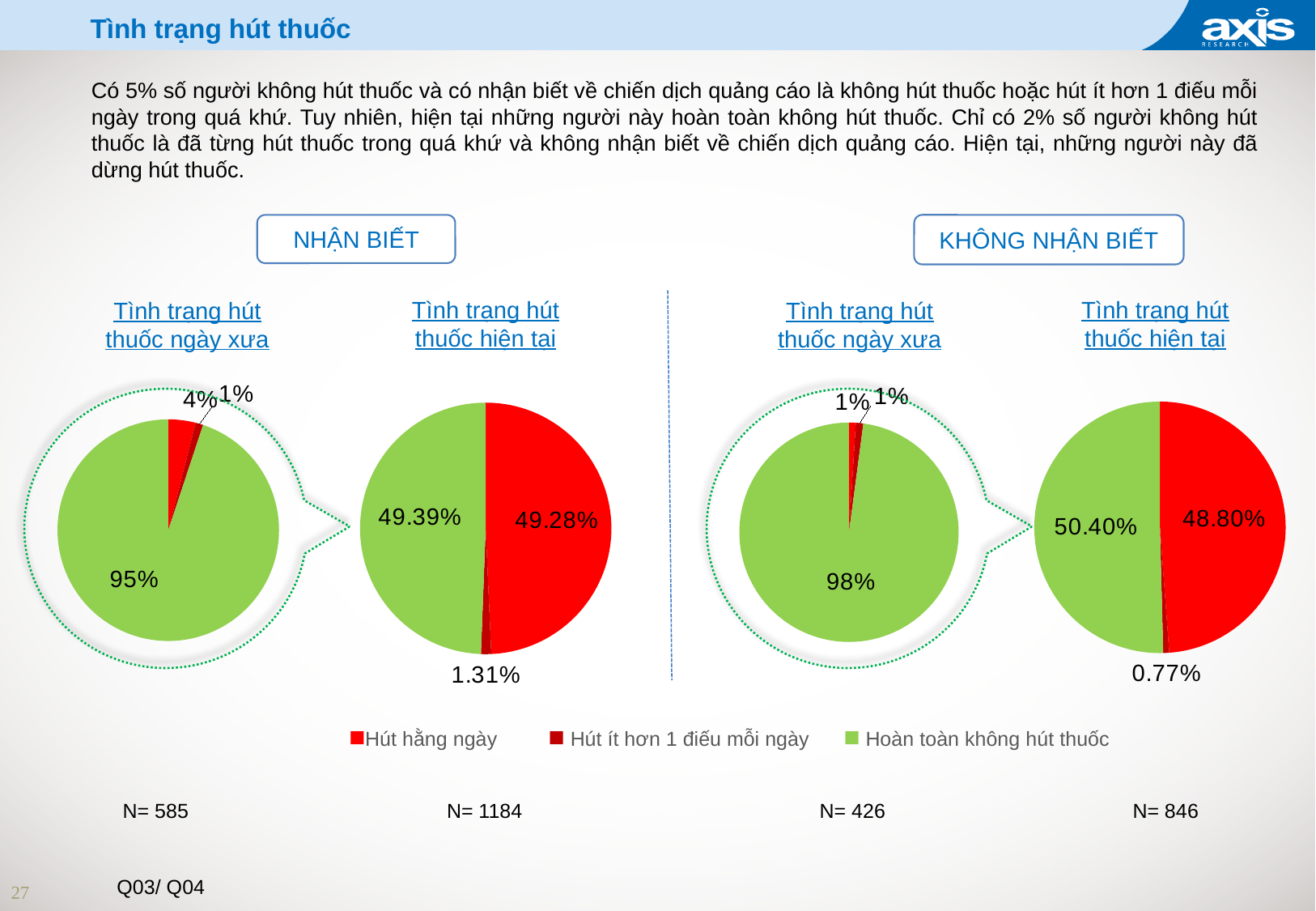
In the 'Tình trạng hút thuốc hiện tại' pie chart under KHÔNG NHẬN BIẾT, what is the difference between Hoàn toàn không hút thuốc (50.40%) and Hút hằng ngày (48.80%)? 1.60% How many categories does the shared legend list for the pie charts? 3 In the 'Tình trạng hút thuốc ngày xưa' pie chart under NHẬN BIẾT, what share is labelled for the largest slice (Hoàn toàn không hút thuốc)? 95% What type of chart is used to show 'Tình trạng hút thuốc hiện tại' under NHẬN BIẾT? Pie chart In the 'Tình trạng hút thuốc ngày xưa' pie chart under KHÔNG NHẬN BIẾT, what is the value for Hoàn toàn không hút thuốc? 98% In the 'Tình trạng hút thuốc hiện tại' pie chart under KHÔNG NHẬN BIẾT, which category has the smallest slice? Hút ít hơn 1 điếu mỗi ngày In the 'Tình trạng hút thuốc hiện tại' pie chart under NHẬN BIẾT, which is larger: Hoàn toàn không hút thuốc or Hút hằng ngày? Hoàn toàn không hút thuốc In the 'Tình trạng hút thuốc hiện tại' pie chart under KHÔNG NHẬN BIẾT, what is the value for Hút hằng ngày? 48.80% In the 'Tình trạng hút thuốc hiện tại' pie chart under NHẬN BIẾT, what is the difference between Hoàn toàn không hút thuốc (49.39%) and Hút hằng ngày (49.28%)? 0.11% What is the sample size (N) shown under the 'Tình trạng hút thuốc hiện tại' chart in the KHÔNG NHẬN BIẾT section? N= 846 In the 'Tình trạng hút thuốc hiện tại' pie chart under NHẬN BIẾT, what is the value for Hút ít hơn 1 điếu mỗi ngày? 1.31% In the 'Tình trạng hút thuốc ngày xưa' pie chart under NHẬN BIẾT, what is the value for Hút hằng ngày? 4%